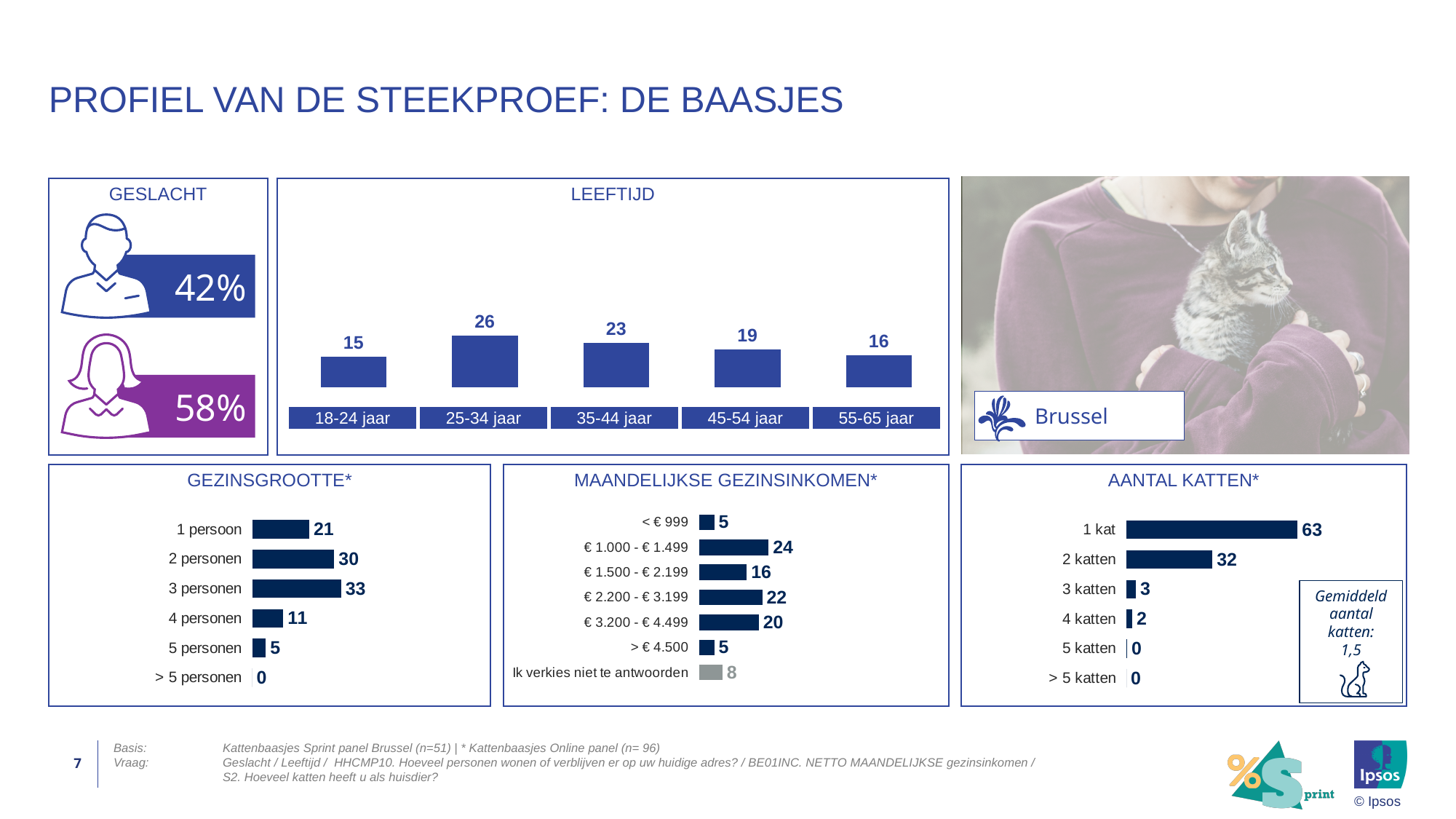
In the LEEFTIJD chart, what is the value for 25-34 jaar? 26 In the GEZINSGROOTTE* chart, which category has the highest value? 3 personen In the LEEFTIJD chart, what is the difference between the values for 25-34 jaar and 55-65 jaar? 10 In the AANTAL KATTEN* chart, what is the difference between the values for 1 kat and 2 katten? 31 In the GEZINSGROOTTE* chart, which is larger: 1 persoon or 4 personen? 1 persoon In the LEEFTIJD chart, how many age categories are shown? 5 In the GEZINSGROOTTE* chart, what is the value for 2 personen? 30 In the MAANDELIJKSE GEZINSINKOMEN* chart, what is the value for € 2.200 - € 3.199? 22 In the MAANDELIJKSE GEZINSINKOMEN* chart, which income category has the highest value? € 1.000 - € 1.499 In the LEEFTIJD chart, which age group has the lowest value? 18-24 jaar What kind of chart is the AANTAL KATTEN* chart? bar chart In the MAANDELIJKSE GEZINSINKOMEN* chart, what is the value for Ik verkies niet te antwoorden? 8